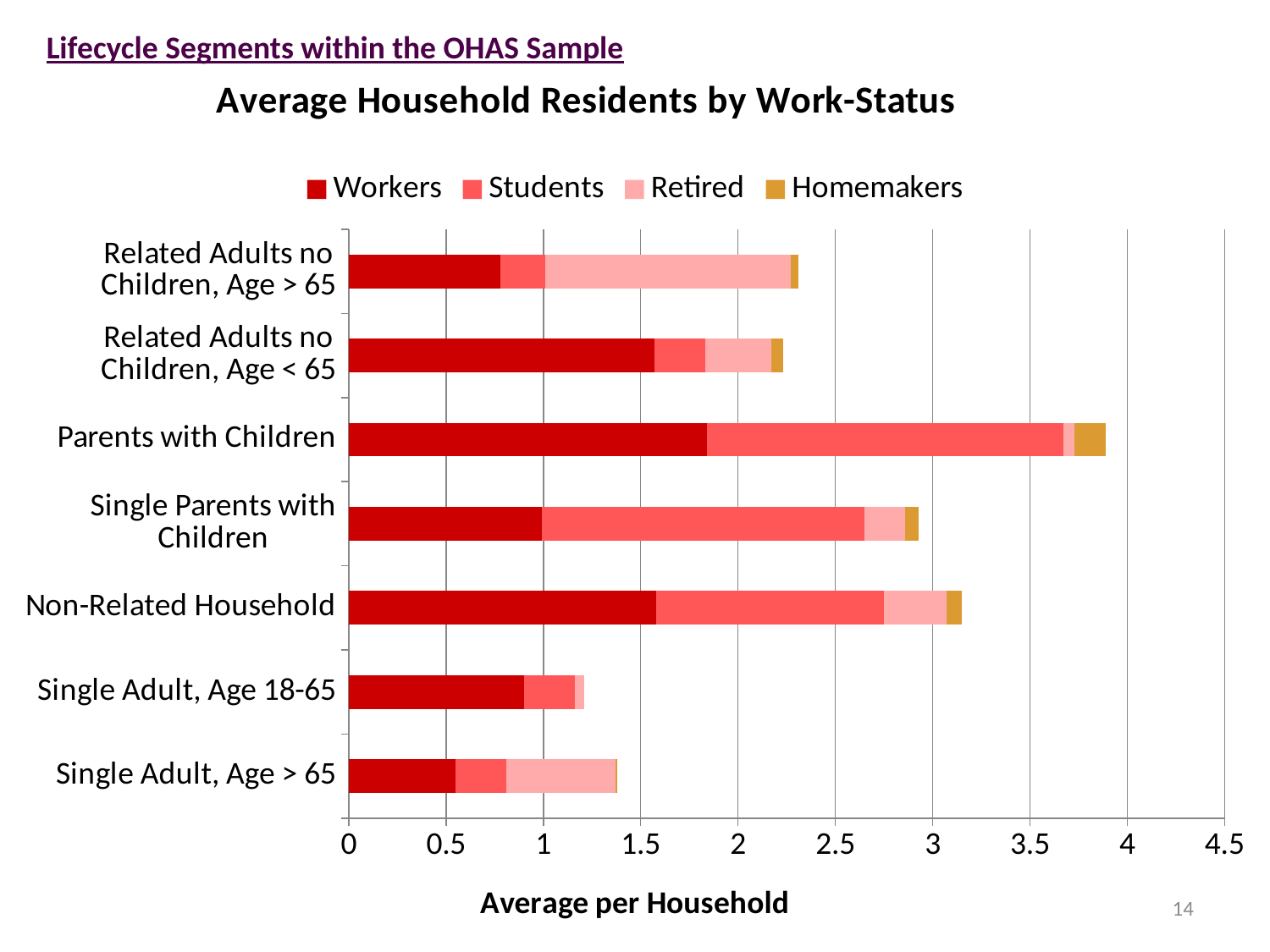
Which household category has the longest total bar? Parents with Children What is the title of the chart? Average Household Residents by Work-Status Which has the larger Workers segment: Parents with Children or Single Parents with Children? Parents with Children Which household category has the shortest total bar? Single Adult, Age 18-65 Is the total bar for Parents with Children greater or less than 3.5? greater Is the total bar for Single Adult, Age > 65 greater or less than 1.5? less What kind of chart is shown on the slide? Stacked bar chart How many household categories are plotted on the chart? 7 Is the Workers segment for Single Adult, Age > 65 greater or less than 1? less What is the label on the horizontal axis? Average per Household How many series does the legend list? 4